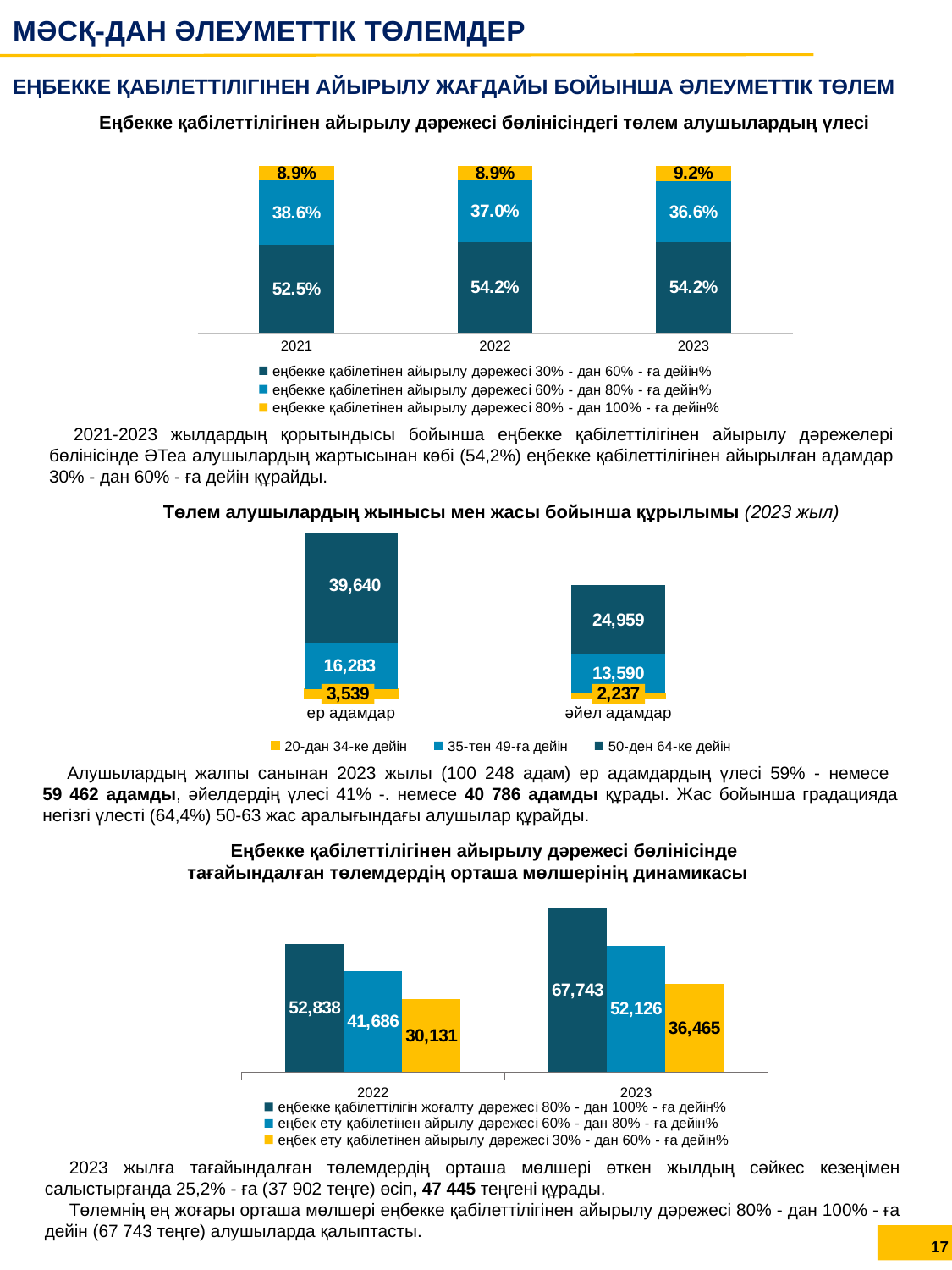
In the bottom chart, which series has the lowest value in 2022? еңбек ету қабілетінен айырылу дәрежесі 30% - дан 60% - ға дейін In the top chart, how many series does the legend list? 3 What type of chart is the bottom chart? bar chart In the top chart (share of recipients by degree of loss of working capacity), what is the value of the 30%–60% series for 2021? 52.5% In the top chart, what is the value of the 80%–100% series for 2023? 9.2% In the middle chart, what is the value of the 20–34 age group for әйел адамдар? 2,237 In the bottom chart, what is the difference between the 60%–80% series values for 2023 and 2022? 10,440 In the bottom chart (dynamics of average payment size), what is the value of the 80%–100% series for 2023? 67,743 In the top chart, does the 60%–80% series rise or fall from 2021 to 2023? fall In the middle chart, what is the difference between the 35–49 values for ер адамдар and әйел адамдар? 2,693 In the middle chart, what is the total of the stacked bar for ер адамдар? 59,462 In the middle chart (structure of recipients by sex and age, 2023), what is the value of the 50–64 age group for ер адамдар? 39,640